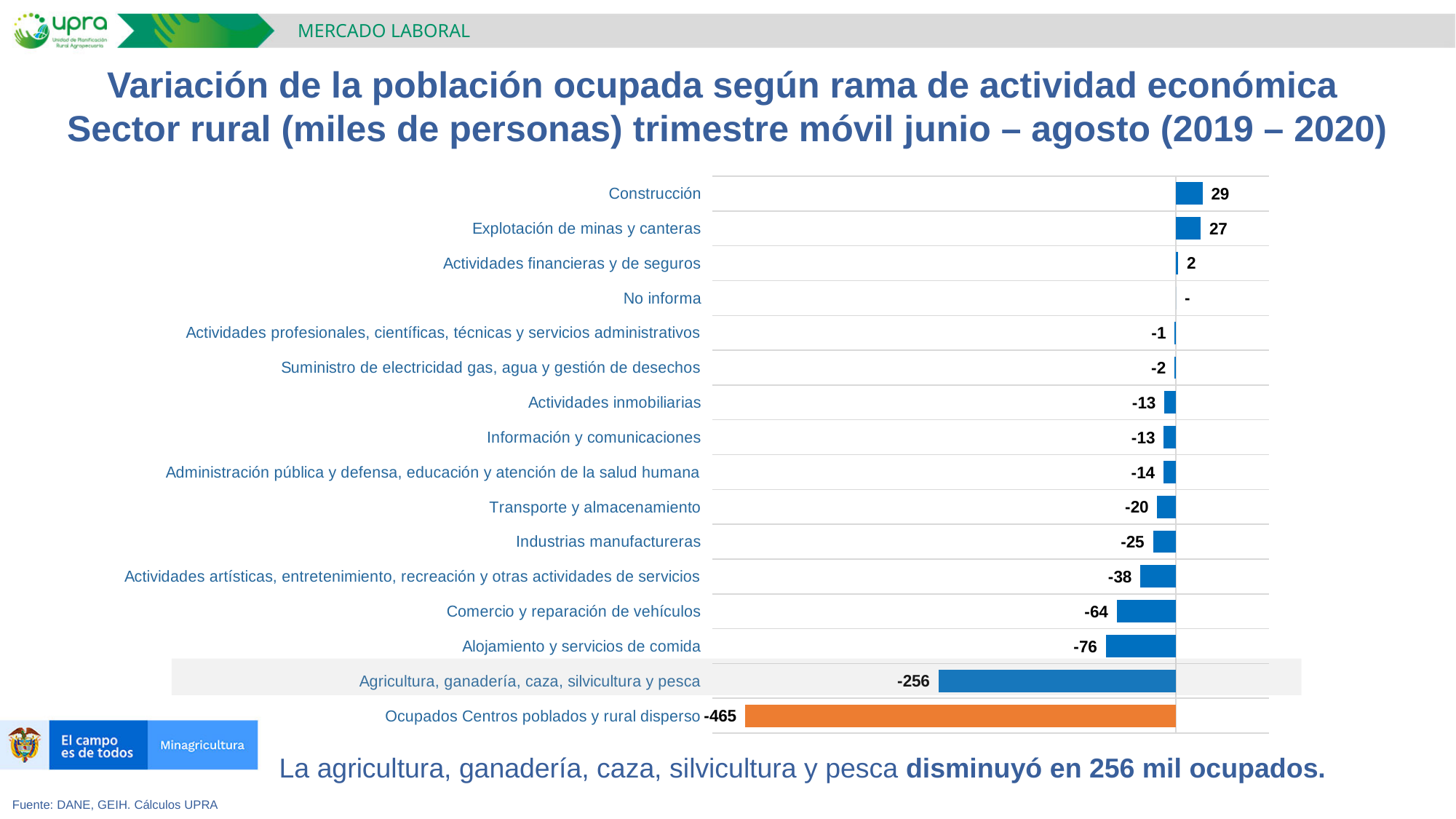
What is the value for Explotación de minas y canteras? 27 What is the value for Agricultura, ganadería, caza, silvicultura y pesca? -256 Which is larger, the value for Transporte y almacenamiento or the value for Industrias manufactureras? Transporte y almacenamiento What is the value for Alojamiento y servicios de comida? -76 Which category has the lowest value? Ocupados Centros poblados y rural disperso Which category's bar is coloured orange instead of blue? Ocupados Centros poblados y rural disperso How many categories are shown in the chart? 16 What kind of chart is shown on the slide? Bar chart What is the difference between the values for Comercio y reparación de vehículos and Alojamiento y servicios de comida? 12 Which category has the highest value? Construcción What is the value for Construcción? 29 What is the value for Ocupados Centros poblados y rural disperso? -465